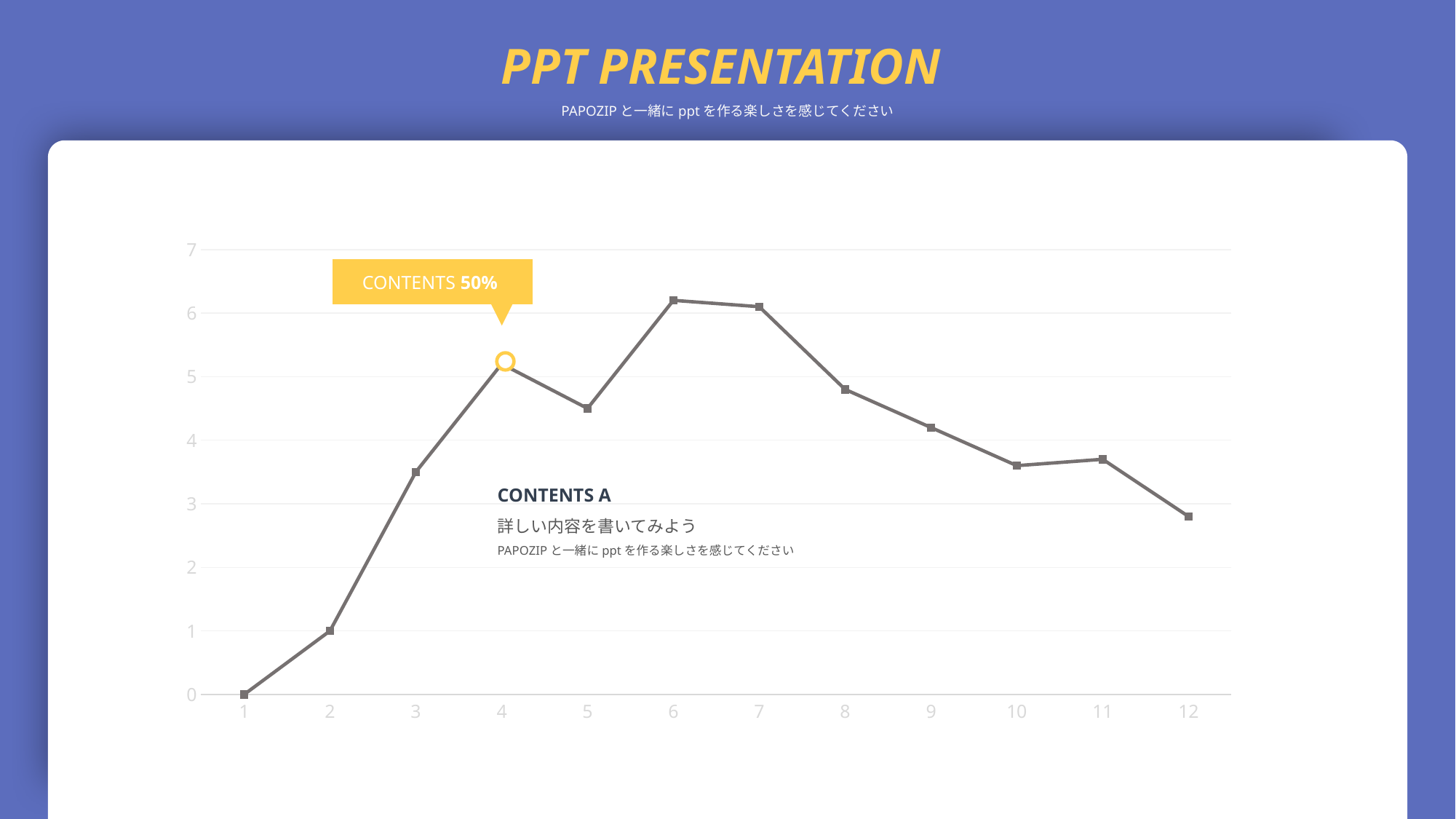
Do the values generally rise or fall from x = 7 to x = 12? fall Do the values rise or fall from x = 1 to x = 4? rise Is the value at x = 12 greater or less than 3? less Is the value at x = 4 greater or less than 5? greater What is the value at x = 2? 1 At which x value is the line lowest? 1 Is the value at x = 6 greater or less than 6? greater Which has the larger value, x = 3 or x = 5? 5 What text is shown in the yellow callout above the highlighted point at x = 4? CONTENTS 50% What is the value at x = 1? 0 What kind of chart is shown on the slide? line chart How many data points are plotted along the x axis? 12